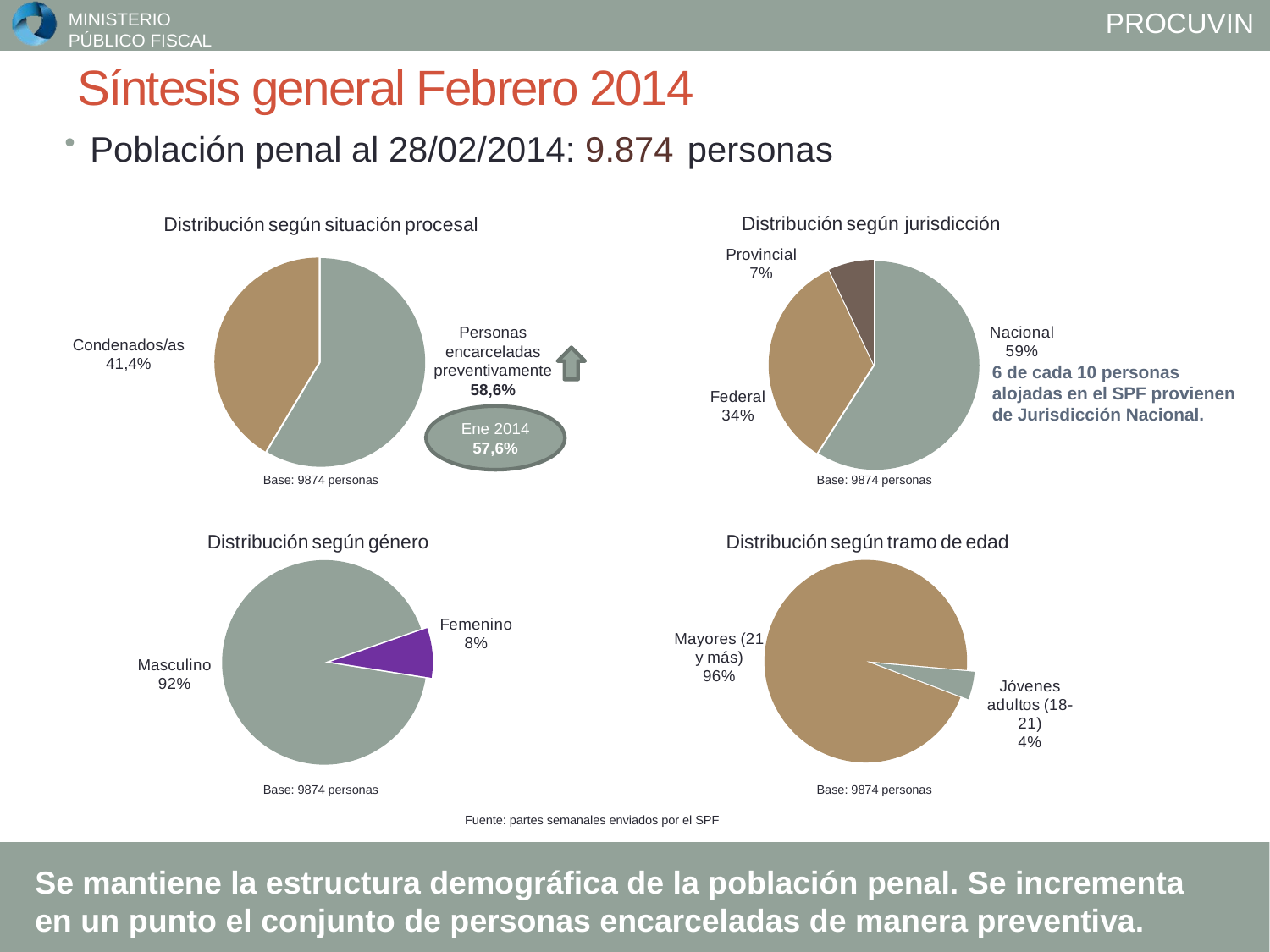
In the 'Distribución según jurisdicción' chart, what is the difference between 'Nacional' and 'Federal'? 25% In the 'Distribución según situación procesal' chart, what is the value for 'Personas encarceladas preventivamente'? 58,6% In the 'Distribución según situación procesal' chart, what share of the pie is 'Condenados/as'? 41,4% In the 'Distribución según género' chart, which is larger, 'Masculino' or 'Femenino'? Masculino In the 'Distribución según tramo de edad' chart, what is the value for 'Jóvenes adultos (18-21)'? 4% In the 'Distribución según jurisdicción' chart, what is the value for 'Federal'? 34% In the 'Distribución según jurisdicción' chart, which category is the largest? Nacional In the 'Distribución según jurisdicción' chart, how many categories are shown? 3 In the 'Distribución según tramo de edad' chart, what is the difference between 'Mayores (21 y más)' and 'Jóvenes adultos (18-21)'? 92% What kind of chart is 'Distribución según género'? Pie chart In the 'Distribución según género' chart, what is the value for 'Femenino'? 8% In the 'Distribución según jurisdicción' chart, which category is the smallest? Provincial